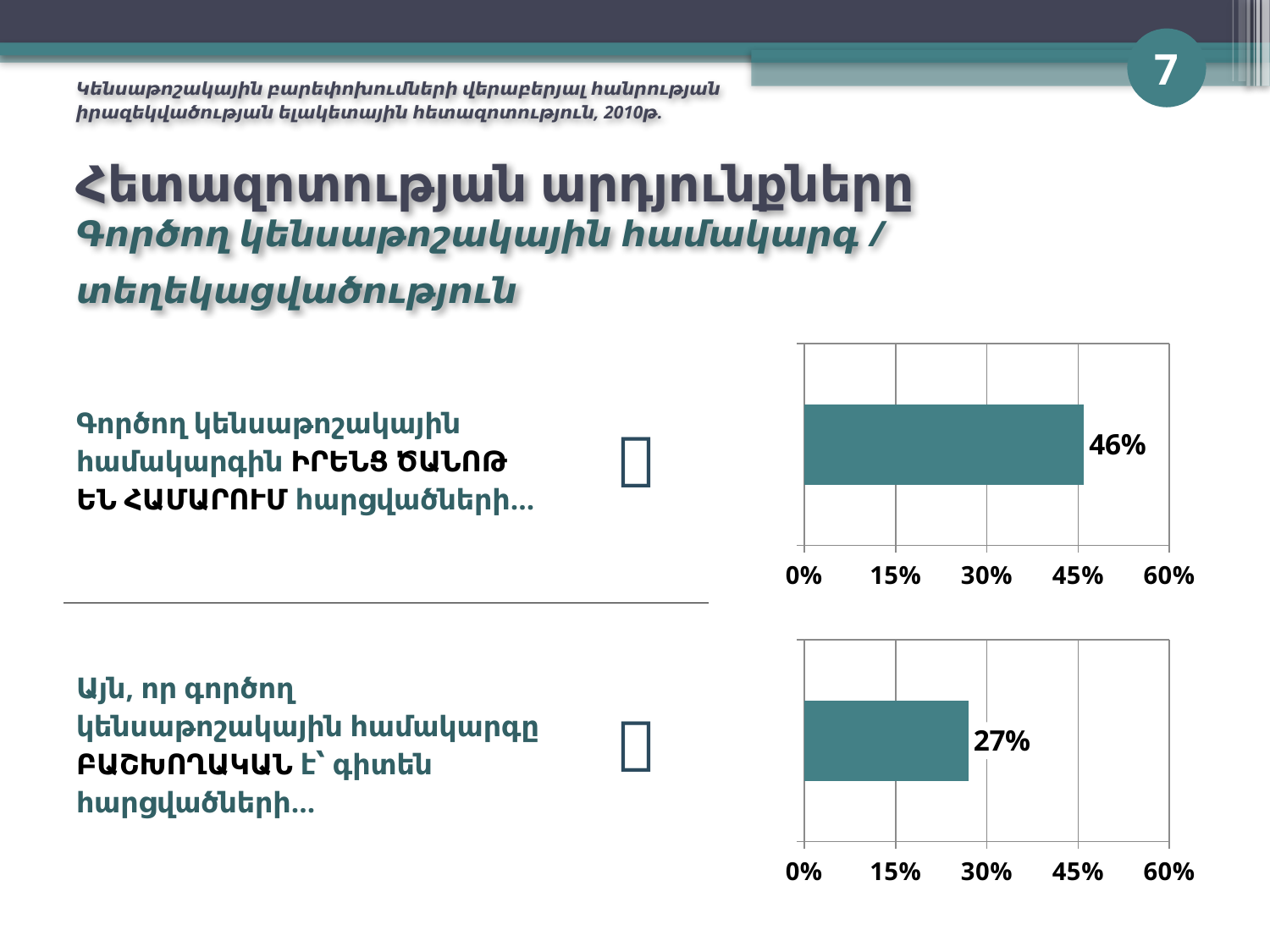
In the bottom chart on the right, what value is shown by the data label on the bar? 27% How many bars are plotted in the bottom chart on the right? 1 Which chart shows the larger value, the top chart (46%) or the bottom chart (27%)? the top chart In the top chart on the right, what value is shown by the data label on the bar? 46% What kind of chart is the bottom chart on the right side of the slide? bar chart What is the interval between the x-axis tick labels in the bottom chart on the right? 15% What is the maximum value shown on the x axis of the top chart on the right? 60% What is the difference between the value in the top chart (46%) and the value in the bottom chart (27%)? 19% In the top chart on the right, is the bar's value greater or less than 45%? greater In the bottom chart on the right, is the bar's value greater or less than 30%? less What kind of chart is the top chart on the right side of the slide? bar chart How many bars are plotted in the top chart on the right? 1